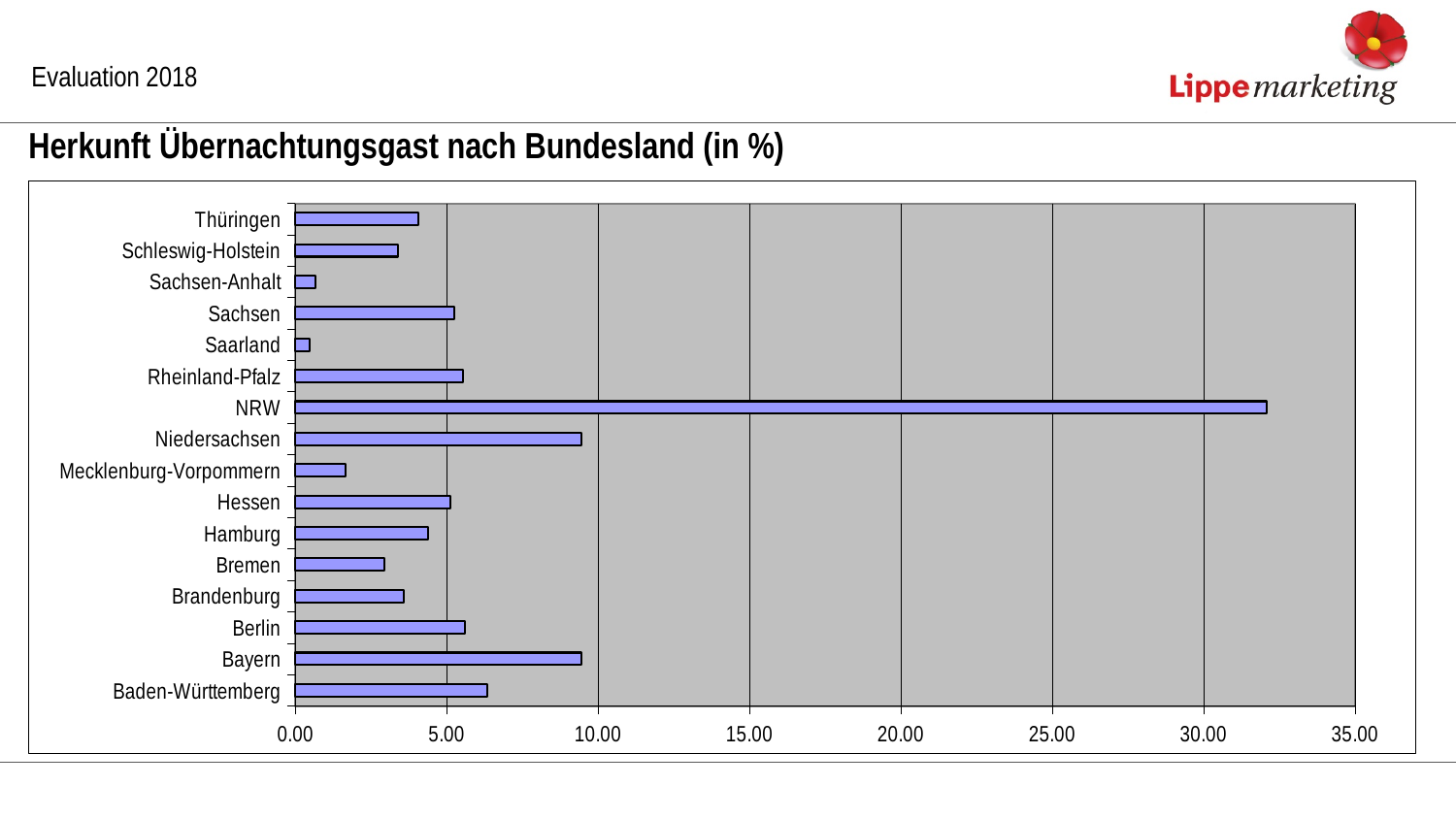
Which has the larger value, Baden-Württemberg or Brandenburg? Baden-Württemberg Which has the larger value, NRW or Niedersachsen? NRW Is the value for Mecklenburg-Vorpommern greater or less than 5? less Is the value for Bayern greater or less than 10? less Is the value for NRW greater or less than 30? greater What is the title of the chart? Herkunft Übernachtungsgast nach Bundesland (in %) What kind of chart is shown on the slide? bar chart How many Bundesländer (categories) are shown in the chart? 16 Which Bundesland has the highest value in the chart? NRW